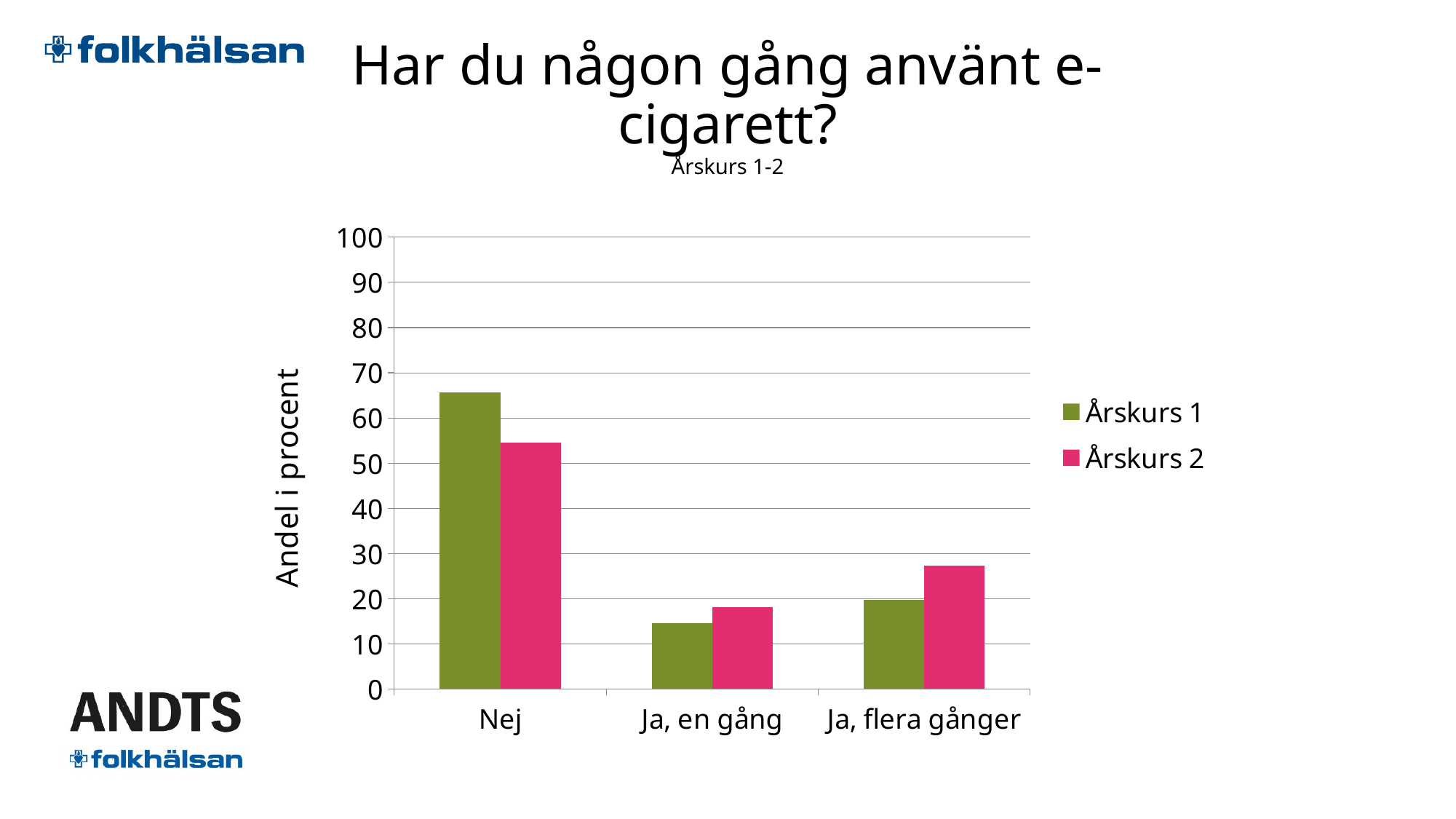
Is the value for Nej in Årskurs 2 greater or less than 60? less Which category has the lowest value for Årskurs 2? Ja, en gång Is the value for Ja, flera gånger in Årskurs 2 greater or less than 20? greater How many series does the legend list? 2 How many categories are shown on the x axis? 3 For Ja, flera gånger, which series has the larger value, Årskurs 1 or Årskurs 2? Årskurs 2 For Nej, which series has the larger value, Årskurs 1 or Årskurs 2? Årskurs 1 What kind of chart is shown on the slide? bar chart Is the value for Nej in Årskurs 1 greater or less than 60? greater What is the label of the y axis? Andel i procent Which category has the lowest value for Årskurs 1? Ja, en gång Which category has the highest value for Årskurs 1? Nej